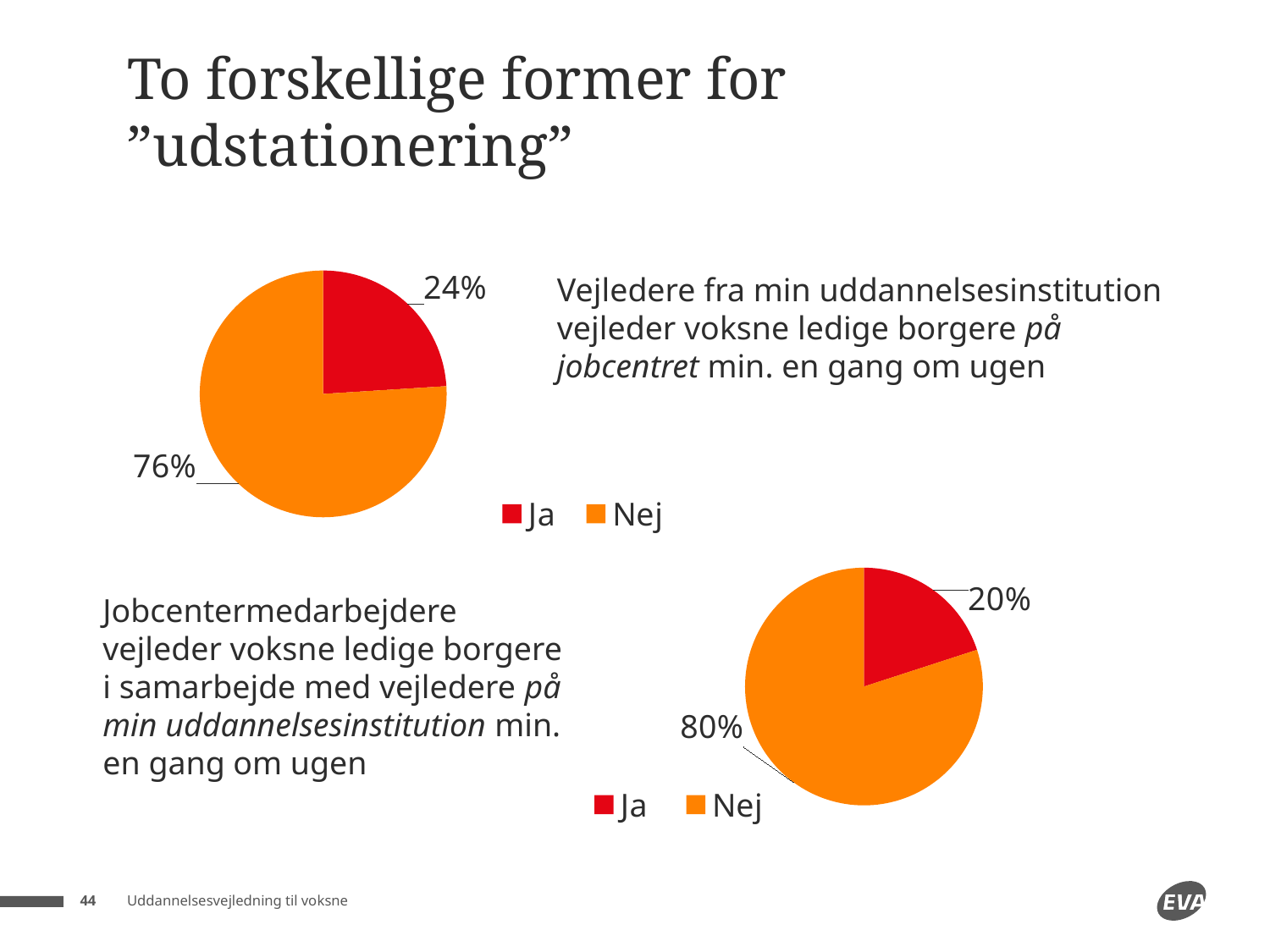
In the lower pie chart, which answer has the smallest slice? Ja What type of chart is used on this slide? Pie chart In the upper pie chart, what share of respondents answered "Ja"? 24% In the upper pie chart, which answer has the largest slice? Nej In the upper pie chart, which colour represents "Ja"? Red In the upper pie chart, what share of respondents answered "Nej"? 76% In the upper pie chart, what is the difference in percentage points between "Nej" and "Ja"? 52 In the lower pie chart, what share of respondents answered "Ja"? 20% How many slices does the lower pie chart have? 2 In the lower pie chart, what share of respondents answered "Nej"? 80% Is the "Ja" share larger in the upper pie chart or the lower pie chart? Upper pie chart In the lower pie chart, what is the difference in percentage points between "Nej" and "Ja"? 60